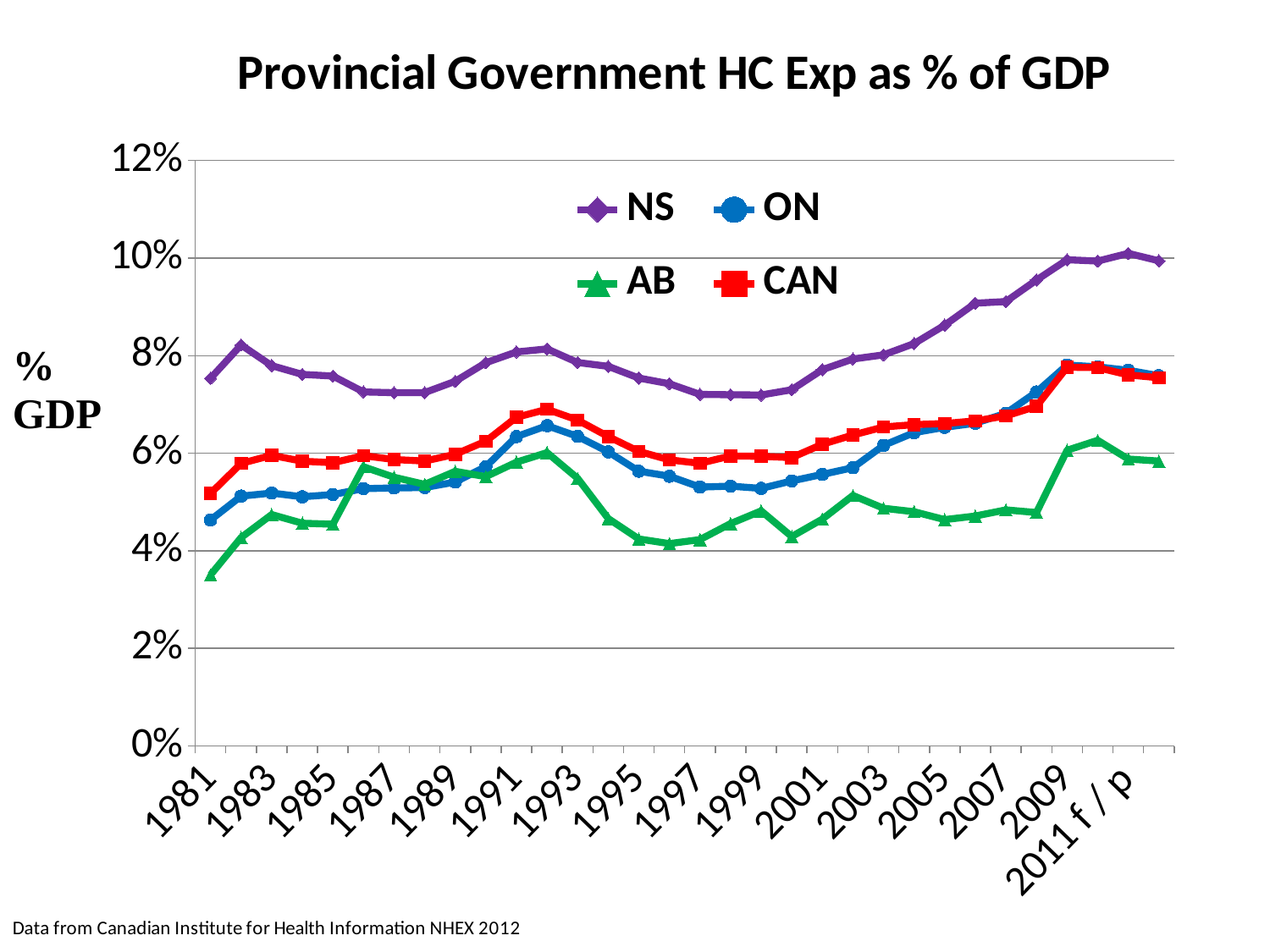
Which series is plotted with a green line and triangle markers? AB In 1997, which is larger, the value for ON or the value for AB? ON What is the title of the chart? Provincial Government HC Exp as % of GDP Is the value for CAN in 1992 greater or less than 6%? greater Does the NS line rise or fall between 1999 and 2009? rise What kind of chart is shown on the slide? line chart Is the value for NS in 1981 greater or less than 6%? greater Which series has the lowest value in 1981? AB How many series does the legend list? 4 Which series has the highest values across the whole period? NS Is the value for AB in 1981 greater or less than 4%? less